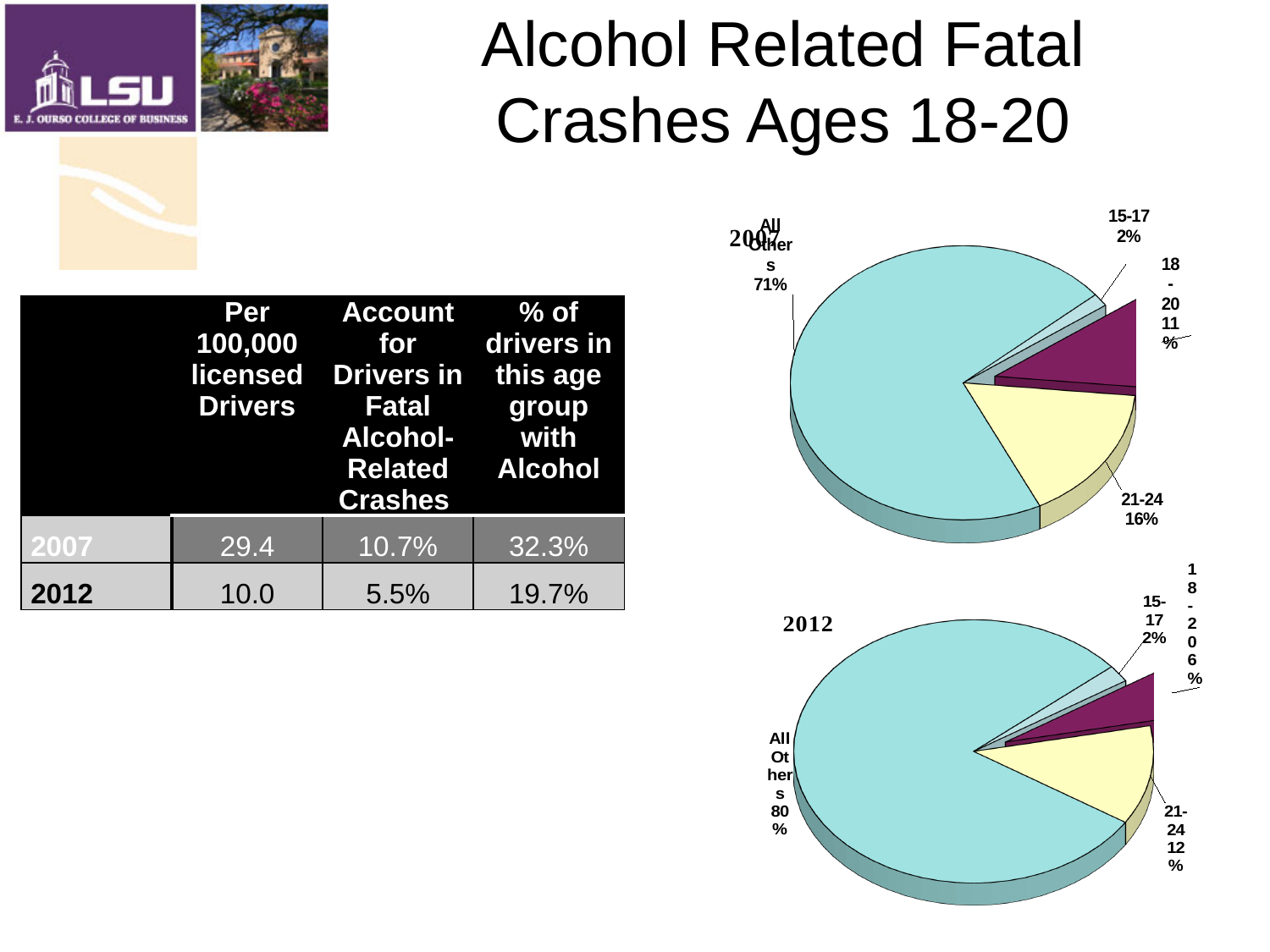
In the 2007 pie chart, what is the difference between the 21-24 share and the 18-20 share? 5% Is the 18-20 share larger in the 2007 pie chart or the 2012 pie chart? 2007 In the 2007 pie chart, what share is labelled for the 21-24 age group? 16% In the 2012 pie chart, which slice is the smallest? 15-17 How many slices does the 2012 pie chart have? 4 In the 2007 pie chart, which slice is the largest? All Others In the 2012 pie chart, what share is labelled for the 18-20 age group? 6% What type of chart is the 2007 chart on the slide? Pie chart In the 2007 pie chart, what share is labelled for the 18-20 age group? 11% In the 2007 pie chart, what share is labelled for All Others? 71% In the 2012 pie chart, what share is labelled for All Others? 80% In the 2012 pie chart, what share is labelled for the 21-24 age group? 12%